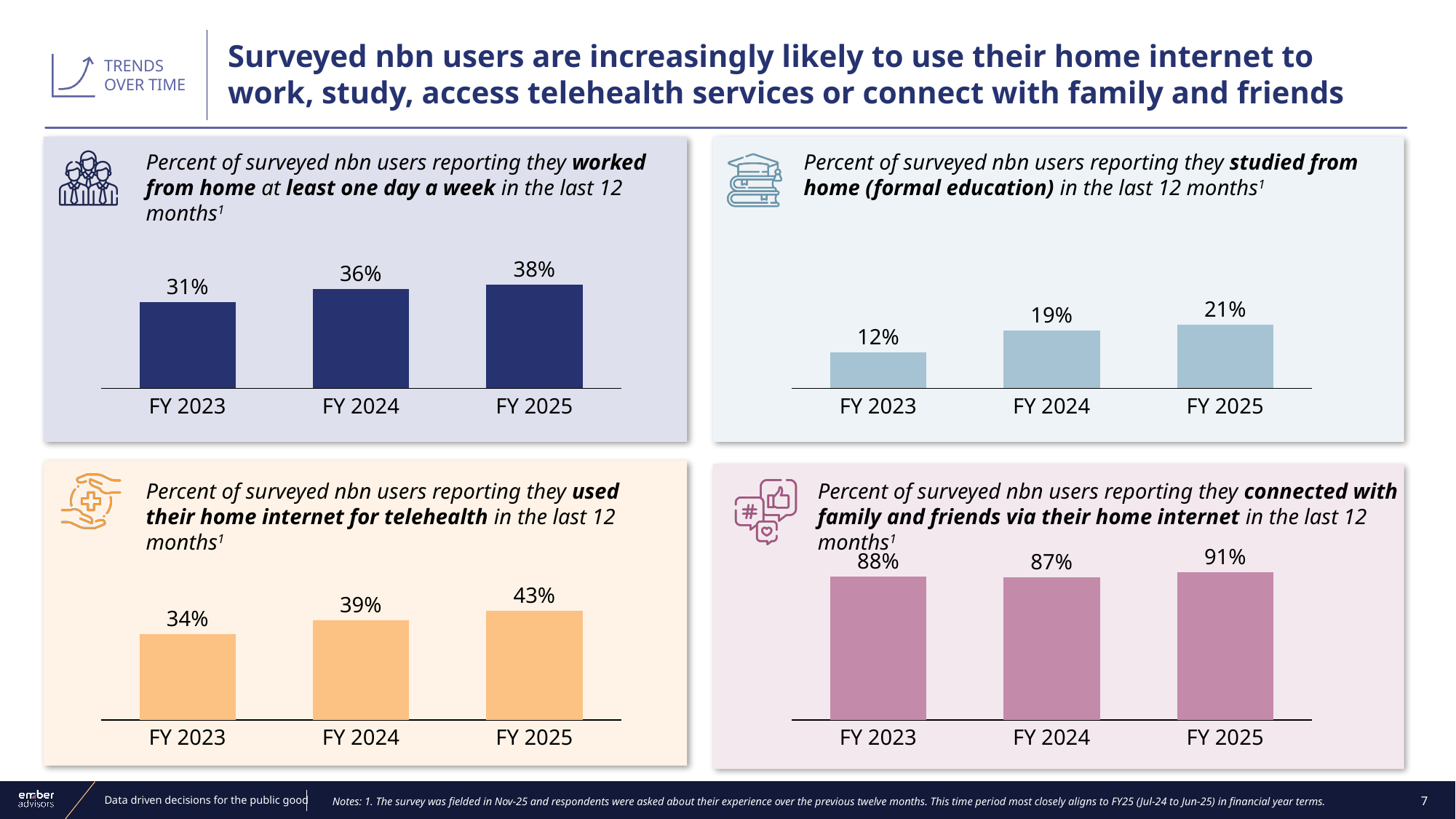
In the 'worked from home' chart (top left), do the values rise or fall from FY 2023 to FY 2025? Rise In the 'worked from home' chart (top left), what is the difference in percentage points between FY 2025 and FY 2023? 7 What type of chart is used in the 'telehealth' panel (bottom left)? Bar chart In the 'connected with family and friends' chart (bottom right), which fiscal year has the lowest value? FY 2024 In the 'studied from home' chart (top right), what is the value for FY 2023? 12% In the 'telehealth' chart (bottom left), by how many percentage points did the value increase from FY 2023 to FY 2025? 9 How many charts are shown on the slide? 4 In the 'connected with family and friends' chart (bottom right), is the value for FY 2023 or FY 2025 larger? FY 2025 In the 'telehealth' chart (bottom left), what is the value for FY 2024? 39% In the 'worked from home' chart (top left), what percent of surveyed nbn users reported working from home at least one day a week in FY 2025? 38% In the 'studied from home' chart (top right), which fiscal year has the highest value? FY 2025 How many fiscal years are shown in the 'studied from home' chart (top right)? 3